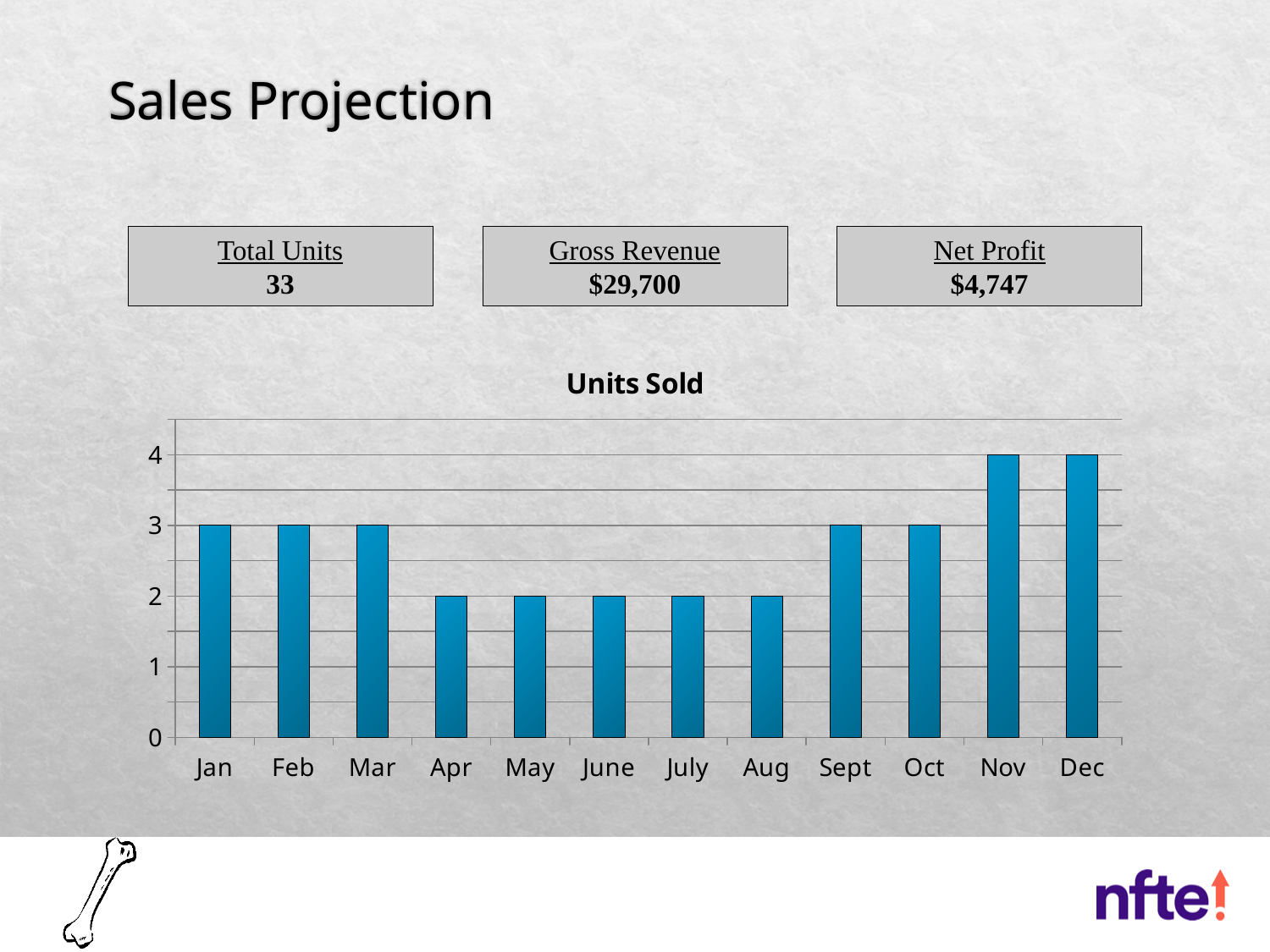
What type of chart is shown on the slide? bar chart Do the values in the Units Sold chart rise or fall from Aug to Dec? rise What is the value for Sept in the Units Sold chart? 3 Which months have the highest value in the Units Sold chart? Nov and Dec What is the value for Nov in the Units Sold chart? 4 What is the difference between the values for Dec and Aug in the Units Sold chart? 2 Which is larger in the Units Sold chart, the value for Mar or the value for June? Mar Is the value for Nov in the Units Sold chart greater or less than 3? greater How many months are shown on the x axis of the Units Sold chart? 12 What is the title of the chart? Units Sold What is the value for Jan in the Units Sold chart? 3 What is the value for Apr in the Units Sold chart? 2